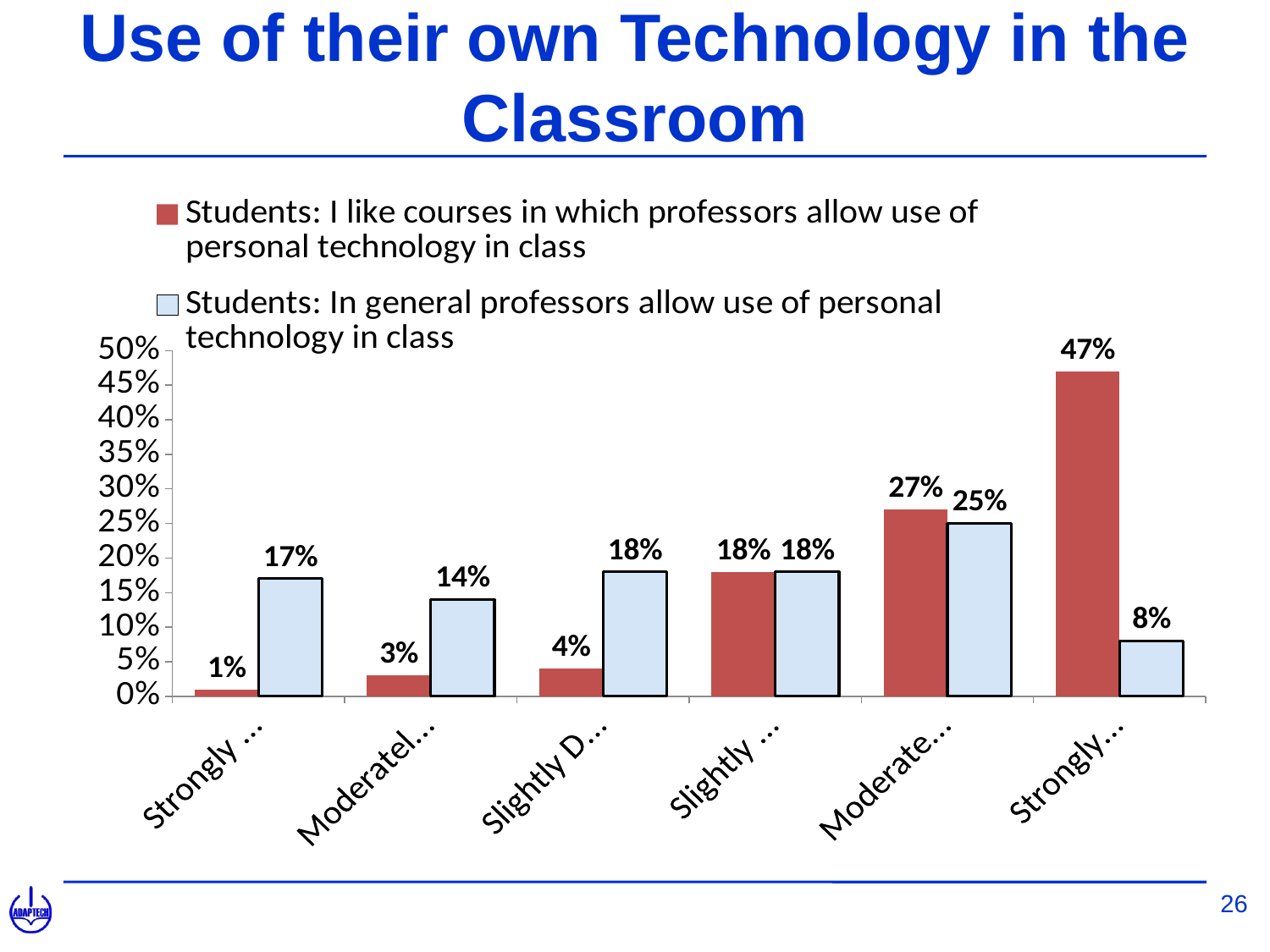
What is the value of the light blue series (Students: In general professors allow use of personal technology in class) for the leftmost category? 17% How many categories are shown on the x axis of the chart? 6 Which category has the lowest value for the red series? The leftmost (first) category, at 1% How many series does the legend list? 2 What type of chart is shown on the slide? Bar chart Which category has the highest value for the red series (I like courses in which professors allow use of personal technology)? The rightmost (sixth) category, at 47% For the third category from the left, how much higher is the light blue series value than the red series value? 14 percentage points (18% vs 4%) Which category has the highest value for the light blue series (In general professors allow use of personal technology)? The fifth category from the left, at 25% For the fifth category from the left, which series has the larger value, red or light blue? Red (27% vs 25%) For the rightmost category, what is the difference between the red series value and the light blue series value? 39 percentage points (47% vs 8%) What is the value of the light blue series for the fifth category from the left? 25% What is the value of the red series (Students: I like courses in which professors allow use of personal technology in class) for the rightmost category? 47%